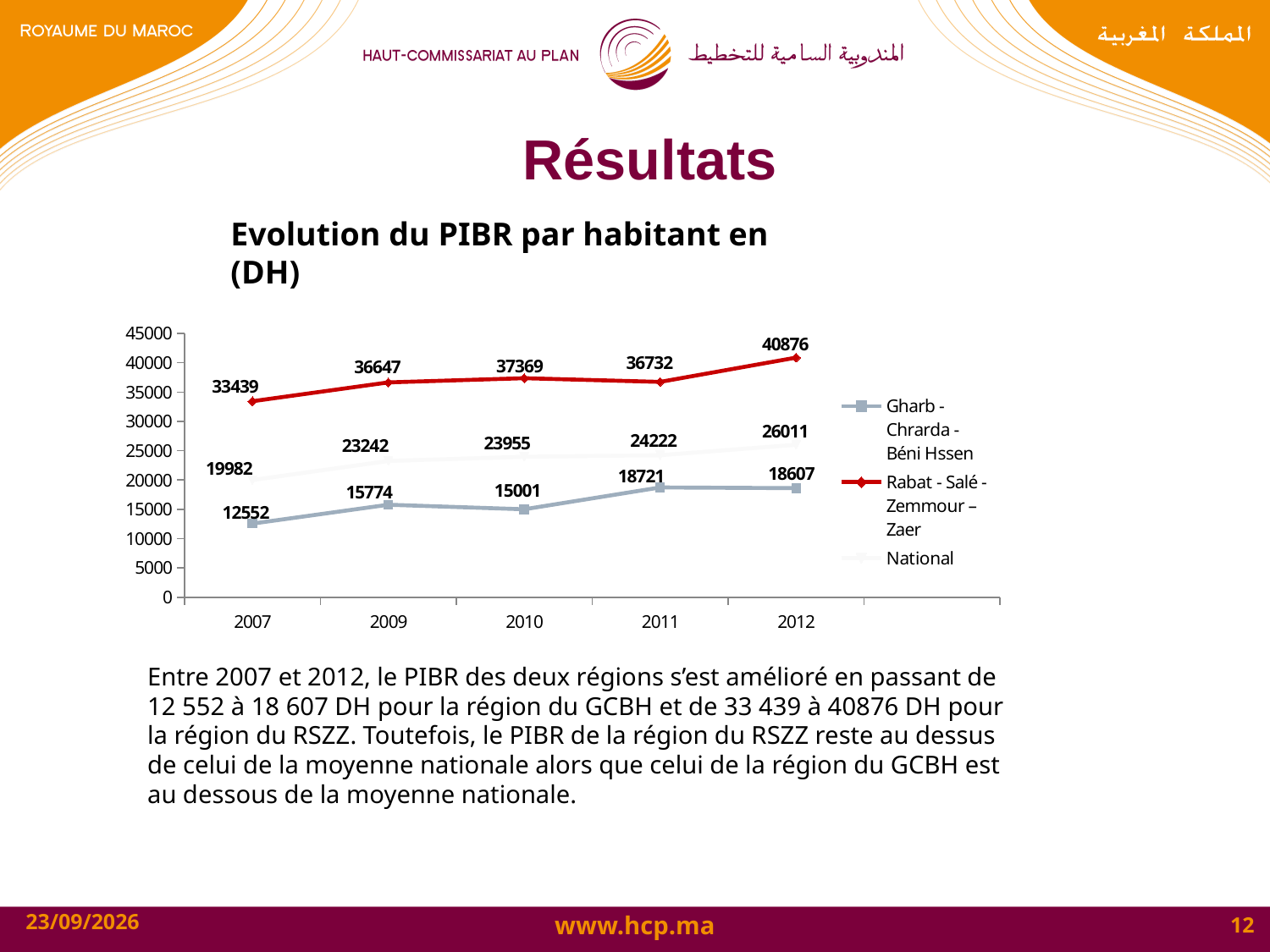
How many series does the legend list? 3 What is the difference between the Rabat - Salé - Zemmour – Zaer value and the Gharb - Chrarda - Béni Hssen value in 2012? 22269 What is the National value in 2010? 23955 What is the title of the chart? Evolution du PIBR par habitant en (DH) Which series has the larger value in 2009, National or Gharb - Chrarda - Béni Hssen? National Does the National series rise or fall from 2007 to 2012? rise What type of chart is shown on the slide? line chart In which year is the value for Rabat - Salé - Zemmour – Zaer lowest? 2007 In which year is the value for Gharb - Chrarda - Béni Hssen highest? 2011 What is the value for Gharb - Chrarda - Béni Hssen in 2007? 12552 How many years are shown on the x axis? 5 What is the value for Rabat - Salé - Zemmour – Zaer in 2012? 40876